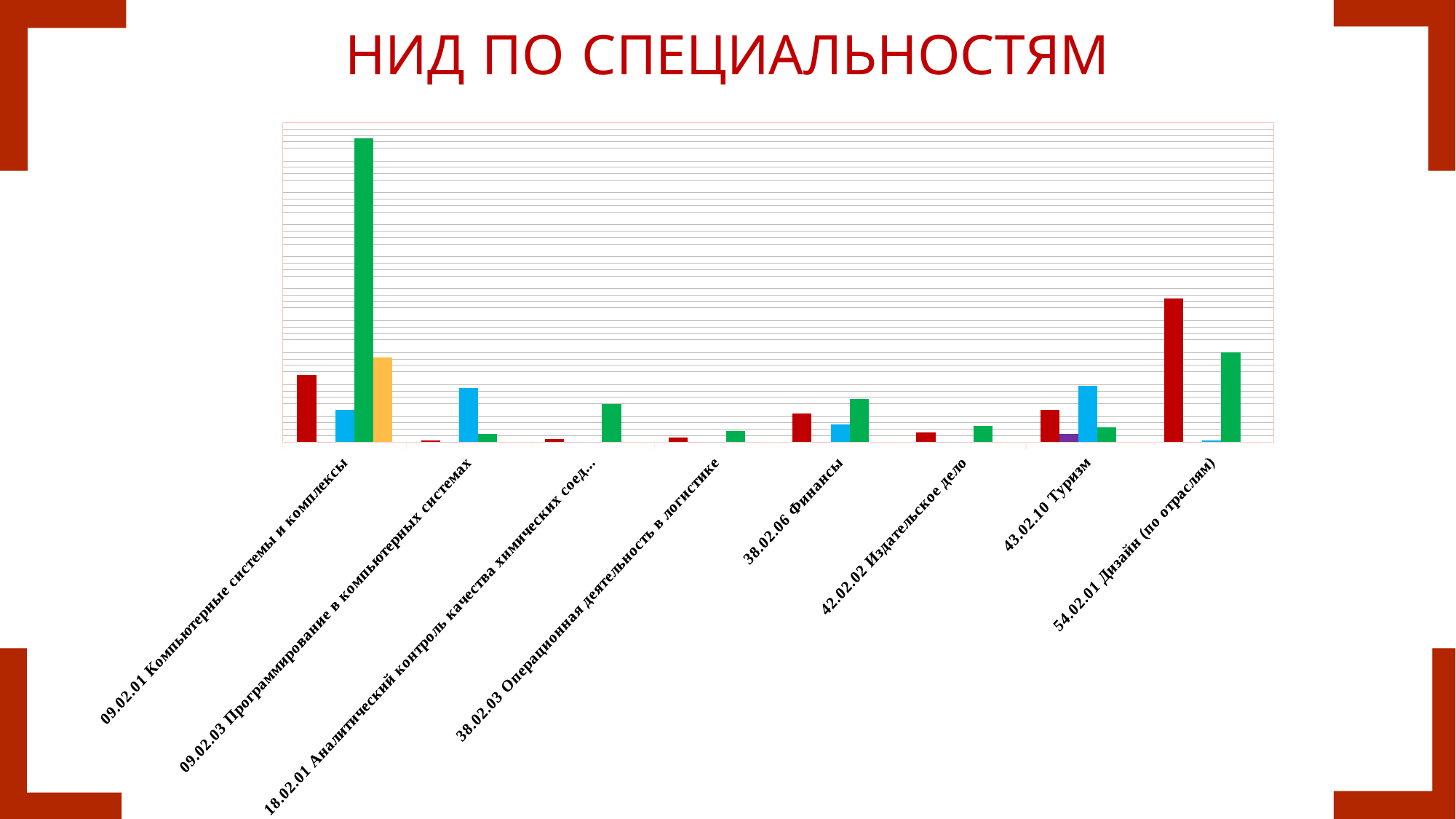
Which category is the only one with an orange bar? 09.02.01 Компьютерные системы и комплексы Is the red bar for 54.02.01 Дизайн (по отраслям) taller or shorter than the red bar for 09.02.01 Компьютерные системы и комплексы? taller Is the green bar for 38.02.06 Финансы taller or shorter than the green bar for 42.02.02 Издательское дело? taller Is the blue bar for 43.02.10 Туризм taller or shorter than the green bar for 43.02.10 Туризм? taller How many bars are plotted for the category 09.02.01 Компьютерные системы и комплексы? 4 How many specialty categories are shown along the x axis of the chart? 8 Which category contains the tallest bar in the chart? 09.02.01 Компьютерные системы и комплексы Which category has the tallest blue bar? 43.02.10 Туризм What kind of chart is shown on the slide? bar chart What colour is the tallest bar in the chart? green Which category has the tallest red bar? 54.02.01 Дизайн (по отраслям)